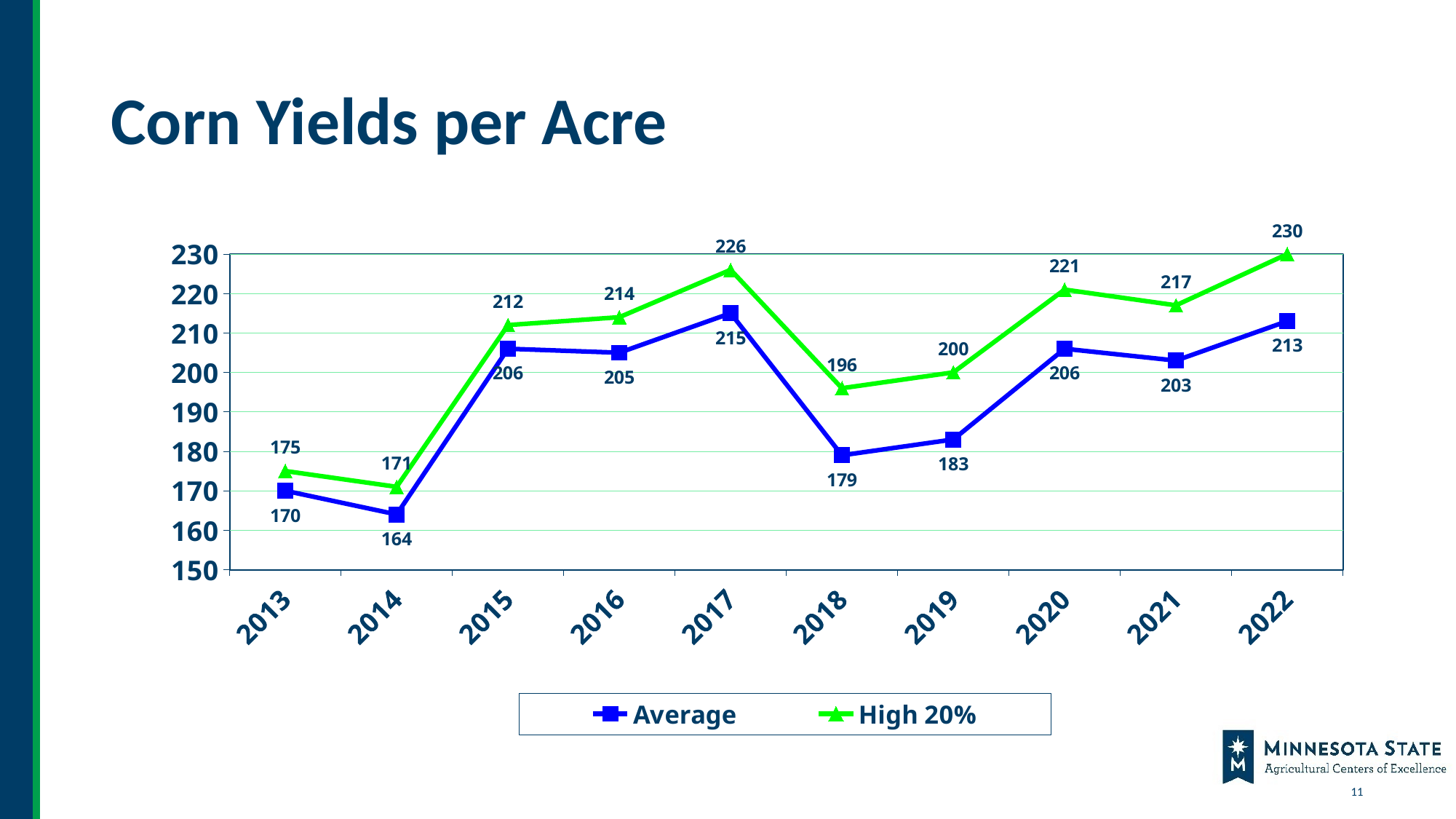
Which is larger, the Average yield in 2020 or the Average yield in 2021? 2020 In which year is the Average yield the lowest? 2014 What is the High 20% corn yield per acre in 2022? 230 What is the Average corn yield per acre in 2017? 215 What kind of chart is shown on the slide? Line chart What is the difference between the High 20% and Average yields in 2018? 17 What is the title of the chart? Corn Yields per Acre How many series does the legend list? 2 In which year is the High 20% yield the highest? 2022 How many years are shown on the x axis? 10 What is the Average corn yield per acre in 2014? 164 Does the Average yield rise or fall from 2017 to 2018? Fall